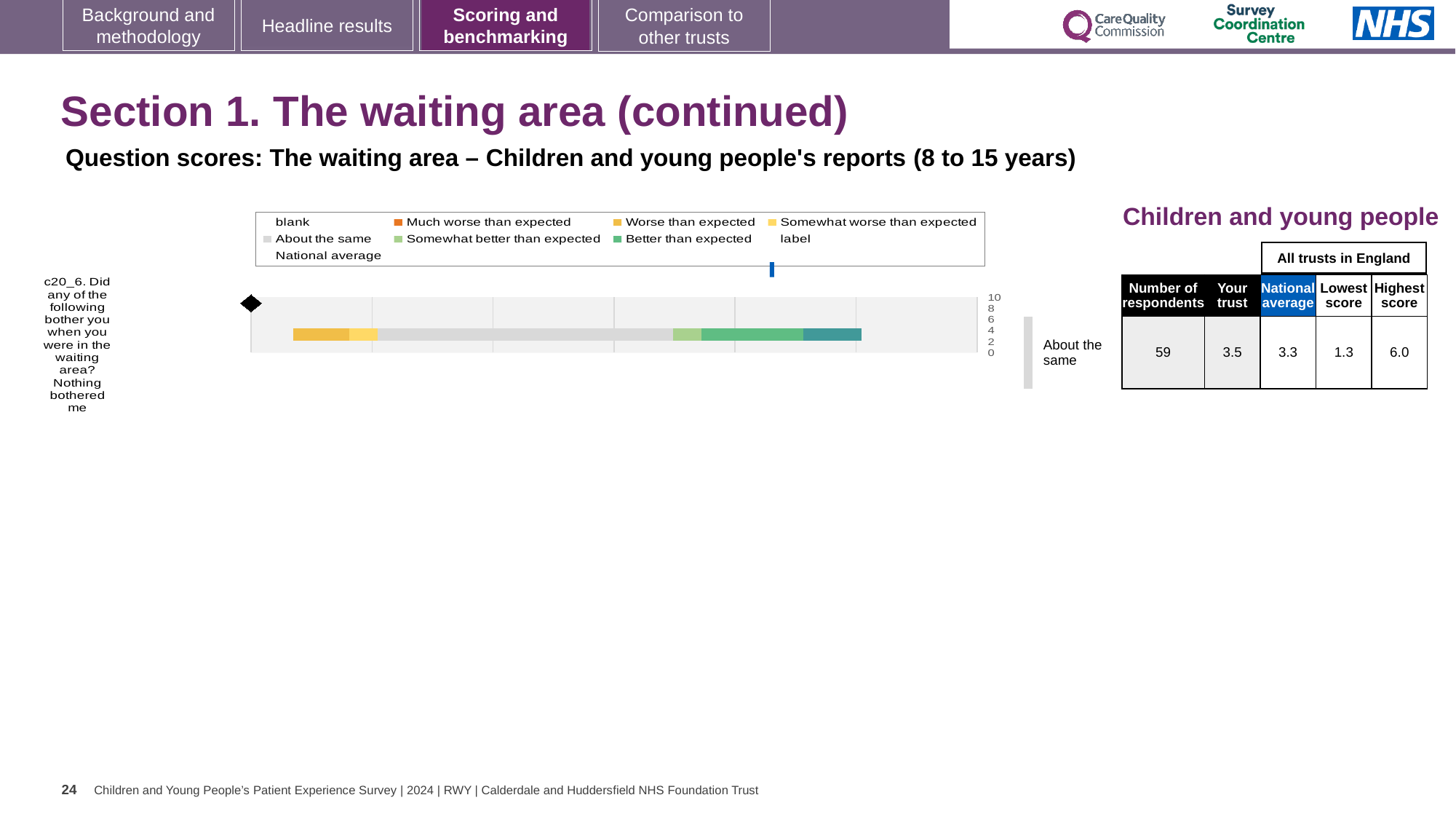
According to the table beside the chart, what is the highest score among all trusts in England for question c20_6? 6.0 According to the table beside the chart, how many respondents answered question c20_6? 59 What is the difference between the 'Your trust' score and the national average for question c20_6? 0.2 What is the difference between the highest score and the lowest score among all trusts in England for question c20_6? 4.7 How many survey questions are plotted in the chart? 1 Which is larger for question c20_6: the 'Your trust' score or the national average? Your trust Which legend entry is shown with the darkest green colour? Better than expected What is the highest tick value shown on the chart's score axis? 10 What benchmark category label is shown to the right of the bar for question c20_6? About the same What kind of chart is used to show the benchmark bands for question c20_6? bar chart According to the table beside the chart, what is the national average score for question c20_6? 3.3 According to the table beside the chart, what is the 'Your trust' score for question c20_6? 3.5